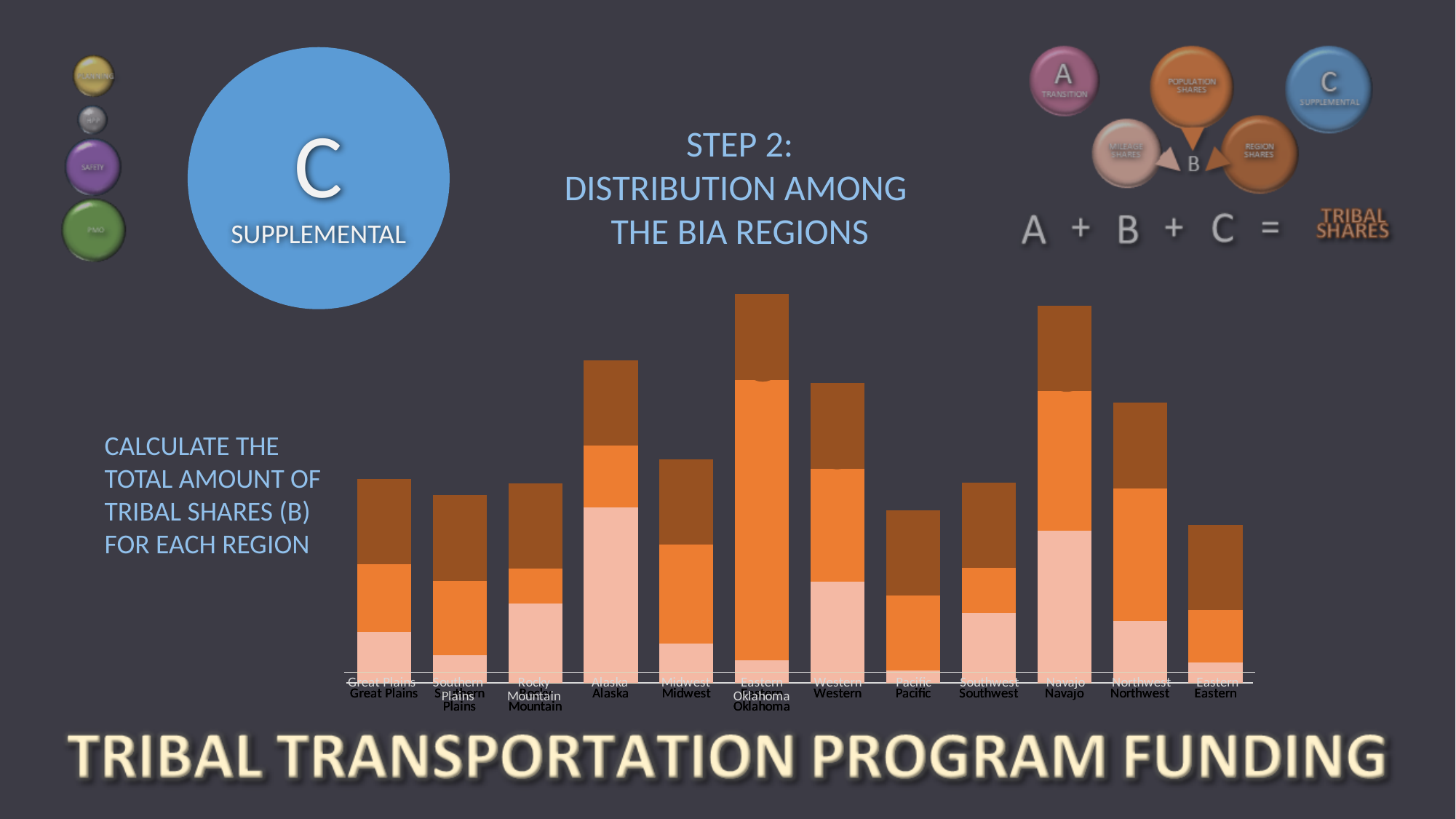
What kind of chart is shown on the slide? Stacked bar chart Which region has the larger light pink (bottom) segment, Alaska or Navajo? Alaska Which region has the shortest stacked bar in the chart? Eastern Which region has the tallest stacked bar in the chart? Eastern Oklahoma How many regions are shown along the x axis of the chart? 12 How many stacked segments make up each bar in the chart? 3 Which region has the taller stacked bar, Alaska or Midwest? Alaska Which region has the taller stacked bar, Navajo or Northwest? Navajo Which region is the first category on the left of the x axis? Great Plains